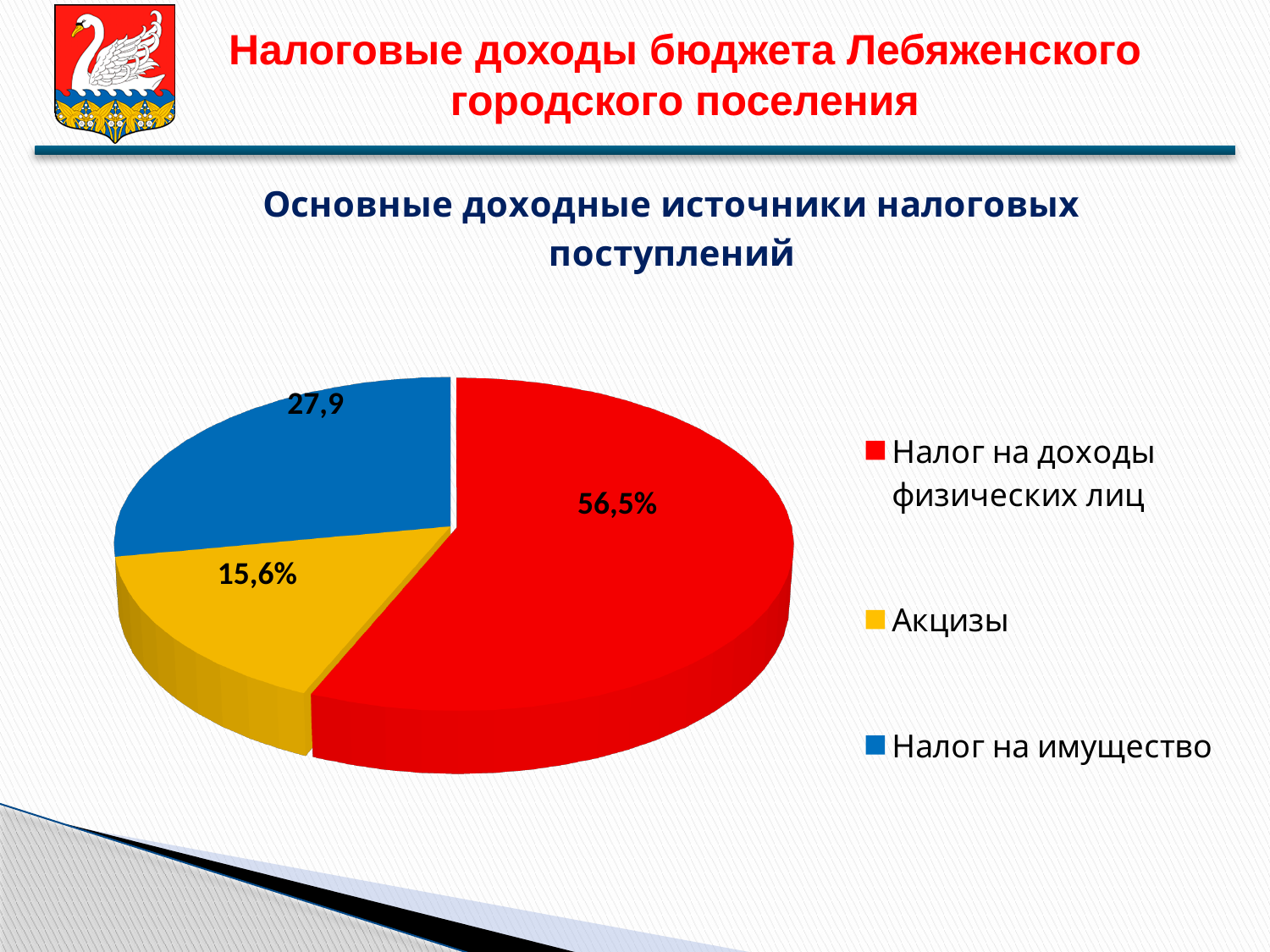
Which category has the smallest slice of the pie? Акцизы What is the title of the chart? Основные доходные источники налоговых поступлений What share of the pie is labelled for Налог на доходы физических лиц? 56,5% How many slices does the pie chart have? 3 What value is printed on the Налог на имущество slice? 27,9 What kind of chart is shown on the slide? Pie chart What value is printed on the Акцизы slice? 15,6% How many entries does the legend list? 3 Which is larger: the share for Налог на имущество or the share for Акцизы? Налог на имущество What colour is the Акцизы slice in the pie chart? Yellow By how many percentage points does Налог на доходы физических лиц exceed Налог на имущество? 28,6 percentage points Which category has the largest slice of the pie? Налог на доходы физических лиц